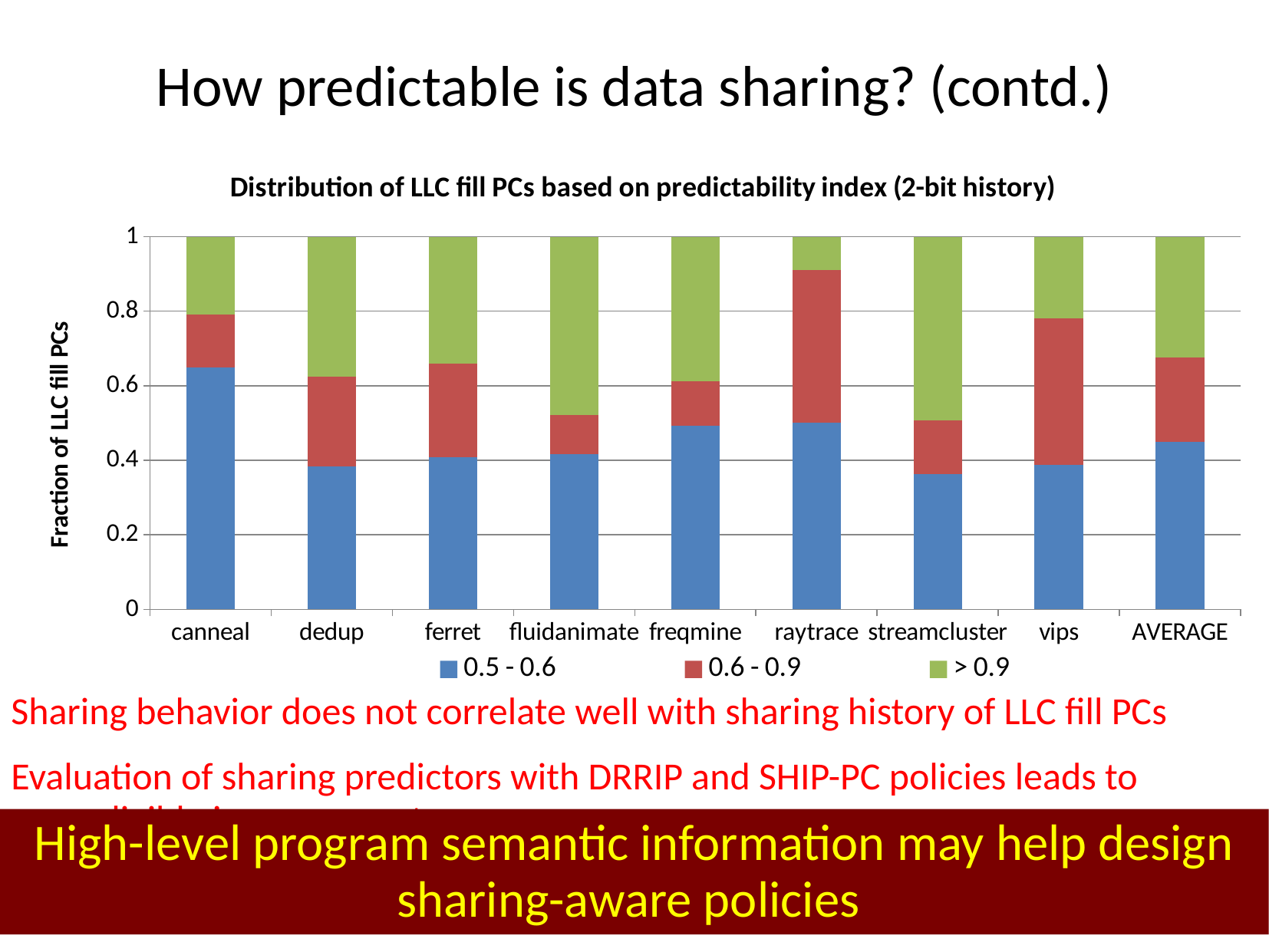
What is the title of the chart? Distribution of LLC fill PCs based on predictability index (2-bit history) Which legend entry is shown in green? > 0.9 Which category has the smallest > 0.9 (green) segment? raytrace What is the total height of the stacked bar for AVERAGE? 1 Which has a larger 0.5 - 0.6 (blue) segment, canneal or dedup? canneal How many benchmark categories are shown on the x axis of the chart? 9 Is the 0.5 - 0.6 value for streamcluster greater or less than 0.4? less How many series does the chart's legend list? 3 Is the 0.5 - 0.6 value for canneal greater or less than 0.6? greater Which category has the largest 0.5 - 0.6 (blue) segment? canneal What kind of chart is shown on the slide? Stacked bar chart Which category has the largest 0.6 - 0.9 (red) segment? raytrace